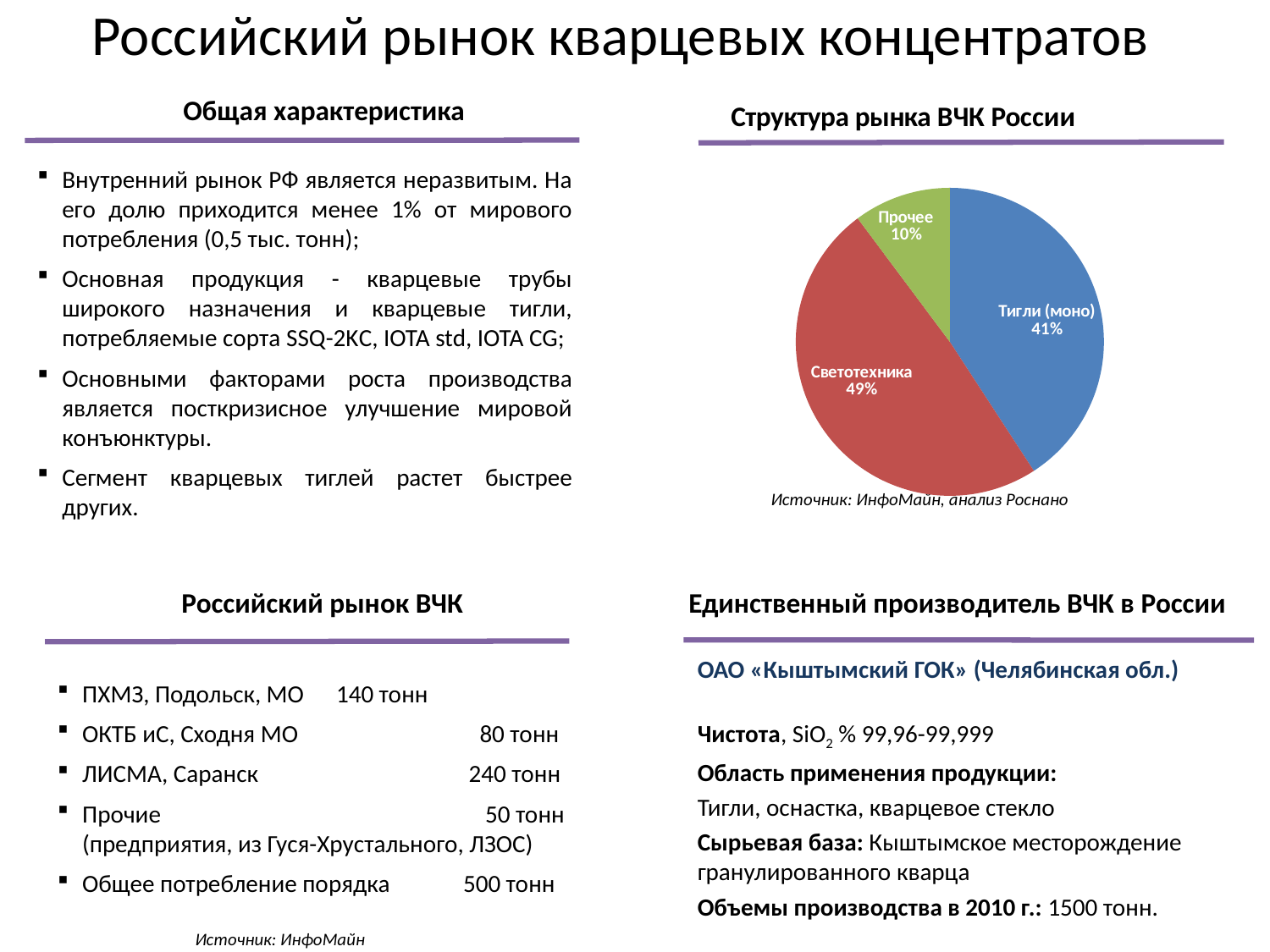
How many slices does the pie chart have? 3 What share of the pie chart does "Прочее" hold? 10% What kind of chart is shown under the heading "Структура рынка ВЧК России"? pie chart What is the difference in percentage points between the "Светотехника" and "Тигли (моно)" slices? 8 What share of the pie chart does "Светотехника" hold? 49% What share of the pie chart does "Тигли (моно)" hold? 41% What is the difference in percentage points between the "Тигли (моно)" and "Прочее" slices? 31 Which is larger in the pie chart: "Тигли (моно)" or "Прочее"? Тигли (моно) Which slice of the pie chart is the largest? Светотехника Which slice of the pie chart is the smallest? Прочее What colour is the "Светотехника" slice in the pie chart? red What source is cited below the pie chart? ИнфоМайн, анализ Роснано